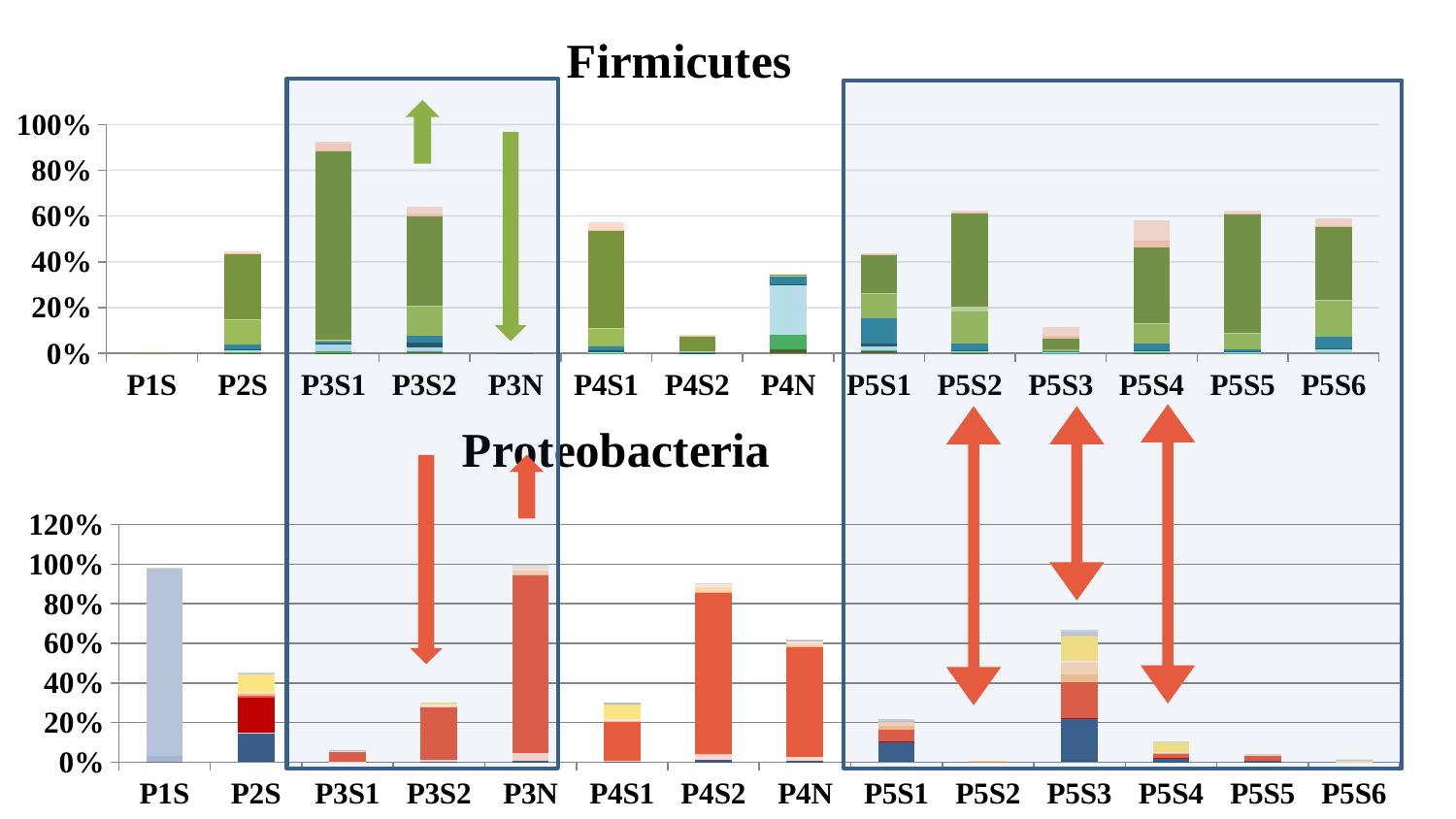
In the Firmicutes chart, which has the larger total, P3S1 or P4S2? P3S1 How many categories are shown on the x axis of the Proteobacteria chart? 14 In the Firmicutes chart, is the total for P4N greater or less than 40%? less In the Firmicutes chart, is the total for P4S2 greater or less than 20%? less What type of chart is the Firmicutes chart? stacked bar chart In the Proteobacteria chart, which has the larger total, P4S2 or P3S1? P4S2 In the Proteobacteria chart, is the total for P4S2 greater or less than 80%? greater What are the titles of the two charts on the slide? Firmicutes and Proteobacteria